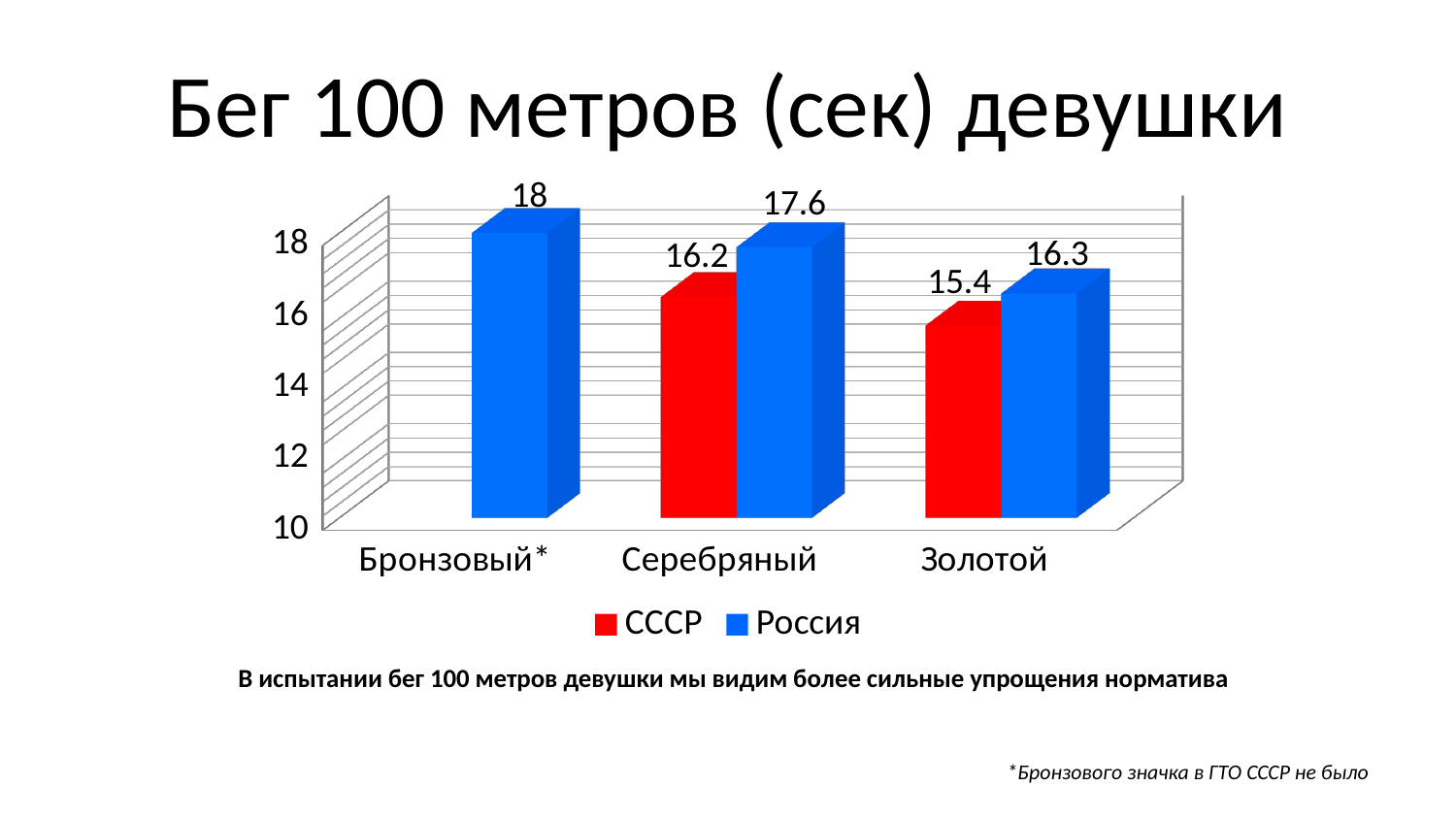
How many categories are shown on the x axis? 3 Which category has the highest value for Россия? Бронзовый How many series does the legend list? 2 What is the value for Россия in the Золотой category? 16.3 What is the value for СССР in the Золотой category? 15.4 What is the value for Россия in the Бронзовый category? 18 What kind of chart is shown on the slide? Bar chart What is the value for СССР in the Серебряный category? 16.2 What is the title of the chart? Бег 100 метров (сек) девушки What is the difference between the Россия and СССР values in the Серебряный category? 1.4 Which category has the lowest value for СССР? Золотой Which is larger in the Золотой category: the value for СССР or for Россия? Россия